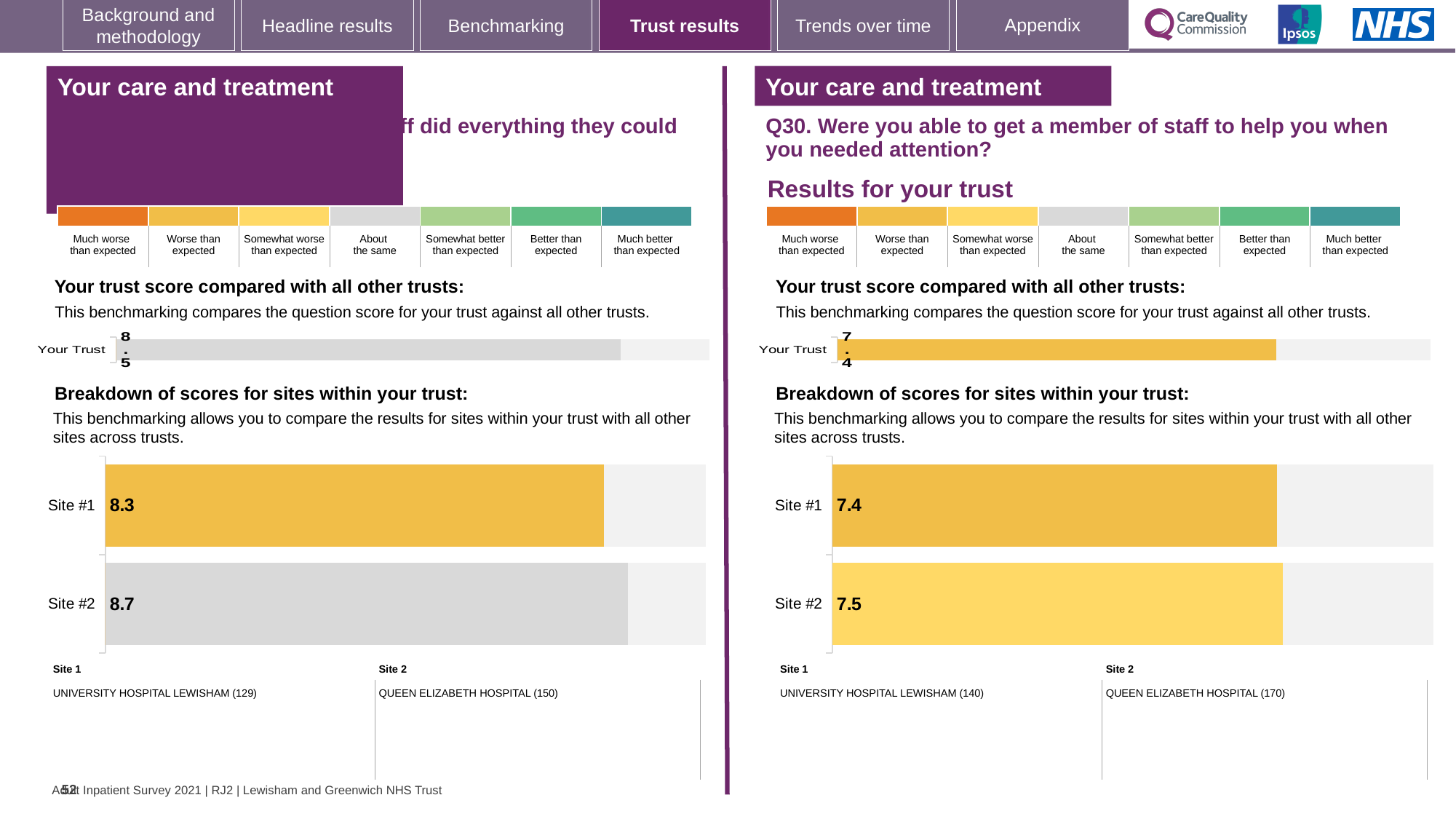
What type of chart is used for the 'Breakdown of scores for sites within your trust' on the left-hand panel? Bar chart How many categories does the colour key above the 'Your trust score compared with all other trusts' section on the right-hand panel list? 7 How many sites are shown in the right-hand panel's (Q30) 'Breakdown of scores for sites within your trust' chart? 2 In the left-hand panel's site breakdown chart, which site has the higher score? Site #2 On the left-hand panel, what is the score shown for Your Trust in the 'Your trust score compared with all other trusts' chart? 8.5 In the left-hand panel's 'Breakdown of scores for sites within your trust' chart, what is the score for Site #2? 8.7 In the left-hand panel's 'Breakdown of scores for sites within your trust' chart, what is the score for Site #1? 8.3 In the left-hand panel's site breakdown chart, what is the difference between the Site #2 and Site #1 scores? 0.4 In the right-hand panel's (Q30) 'Breakdown of scores for sites within your trust' chart, what is the score for Site #2? 7.5 On the right-hand panel (Q30), what is the score shown for Your Trust in the 'Your trust score compared with all other trusts' chart? 7.4 In the right-hand panel's (Q30) site breakdown chart, what is the difference between the Site #2 and Site #1 scores? 0.1 In the right-hand panel's (Q30) 'Breakdown of scores for sites within your trust' chart, what is the score for Site #1? 7.4